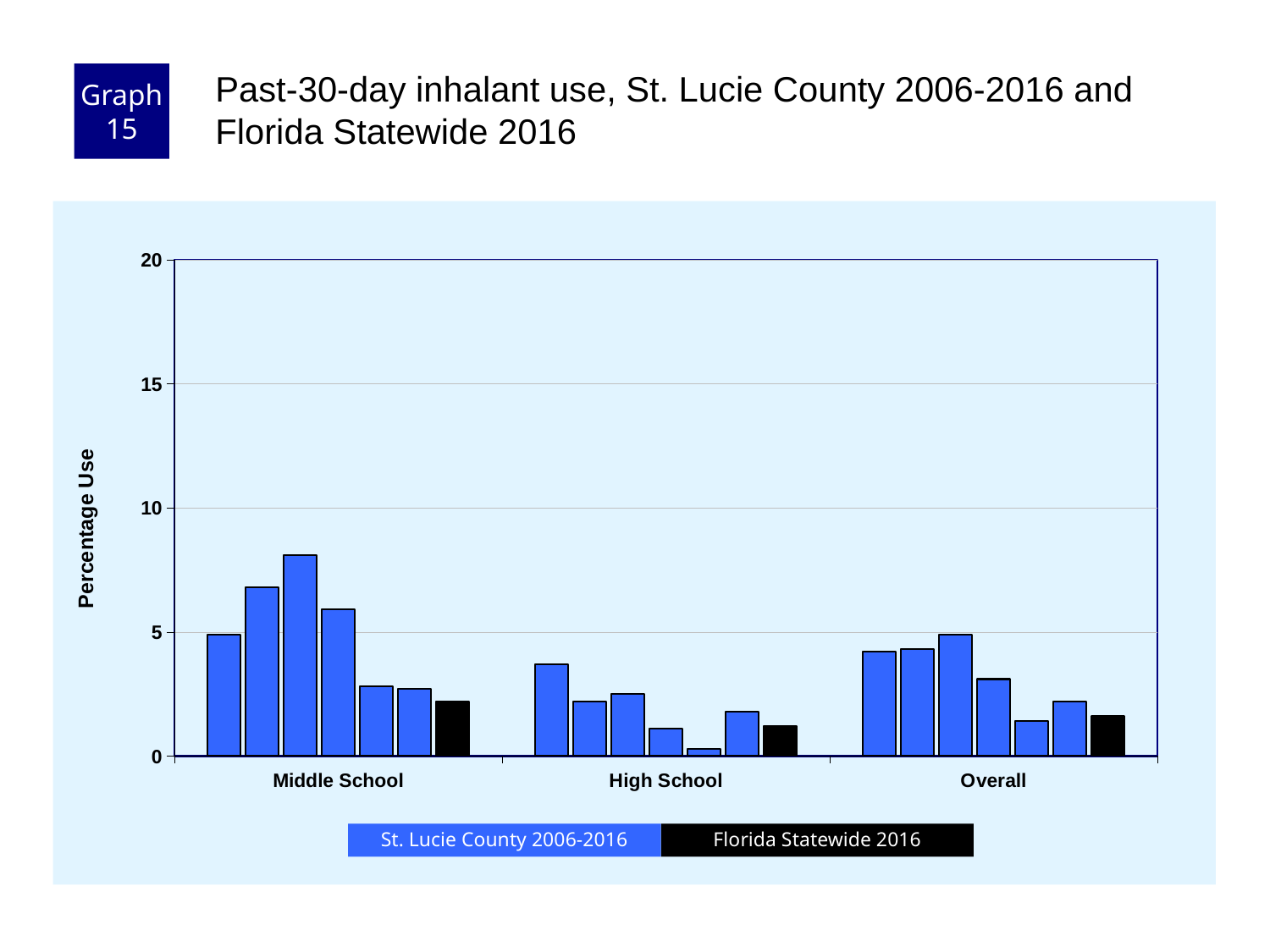
Is the Florida Statewide 2016 value for Middle School greater or less than 5? less What kind of chart is shown on the slide? bar chart Is the tallest St. Lucie County 2006-2016 bar for High School greater or less than 5? less Which category has the lowest Florida Statewide 2016 value? High School Which is larger: the Florida Statewide 2016 value for Middle School or for High School? Middle School Is the tallest St. Lucie County 2006-2016 bar for Middle School greater or less than 10? less Which category has the highest Florida Statewide 2016 value? Middle School How many school-level categories are shown on the x axis? 3 How many series does the legend list? 2 What is the label on the vertical axis? Percentage Use Which colour represents Florida Statewide 2016 in the legend? black